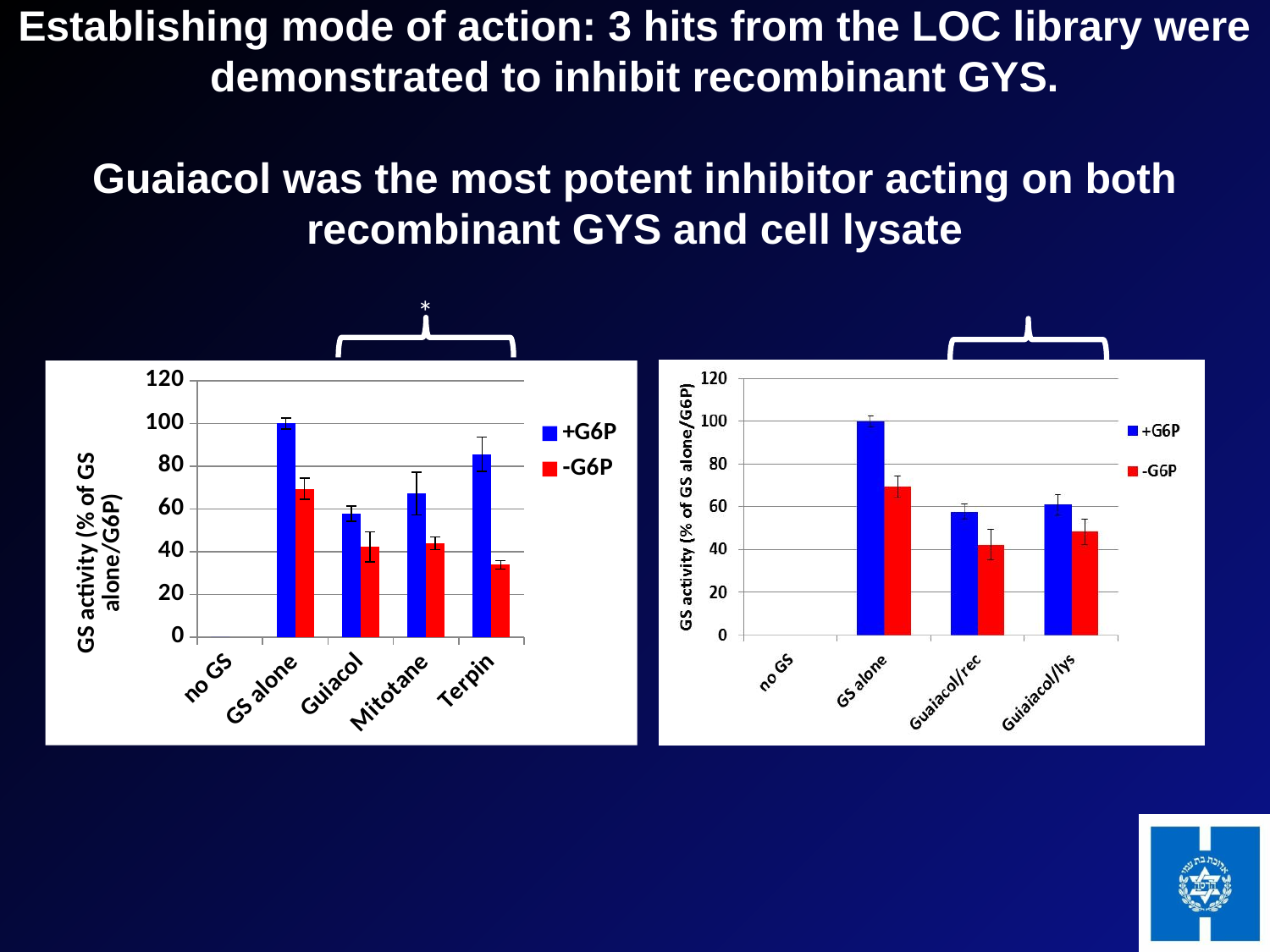
On the right chart, how many categories are shown on the x axis? 4 On the right chart, what are the two legend entries? +G6P and -G6P On the left chart, how many series does the legend list? 2 On the right chart, which category has the highest -G6P value? GS alone On the left chart, which category has the highest +G6P value? GS alone On the left chart, for Mitotane, which is larger: the +G6P value or the -G6P value? +G6P On the right chart, is the +G6P value for Guaiacol/lys greater or less than 40? greater On the left chart, how many categories are shown on the x axis? 5 On the left chart, is the +G6P value for Terpin greater or less than 60? greater On the left chart, what is the +G6P value for GS alone? 100 On the left chart, what kind of chart is shown? bar chart On the left chart, is the -G6P value for Terpin greater or less than 40? less